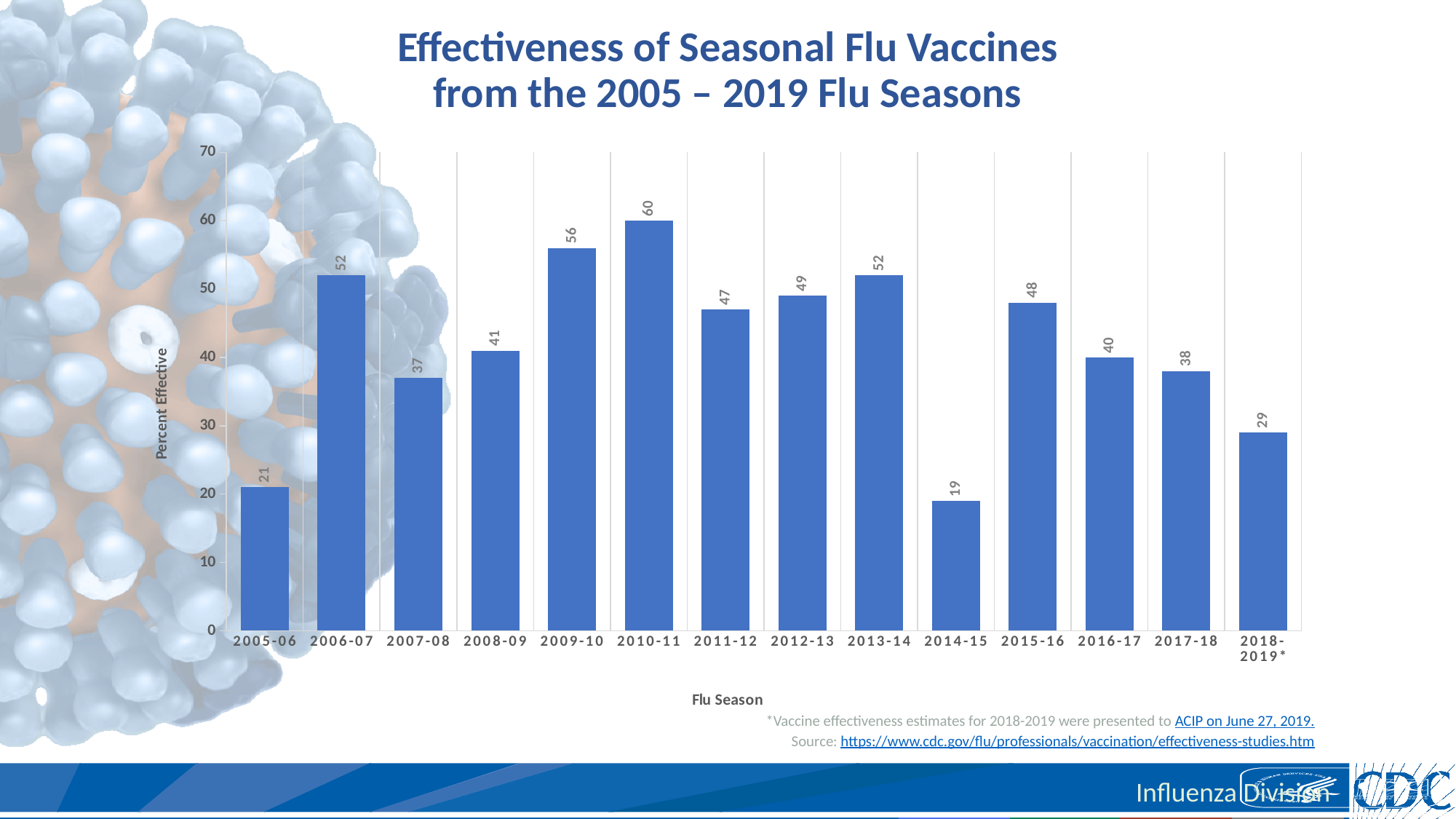
Is the value for the 2005-06 season greater or less than 30? less Which flu season has the highest vaccine effectiveness? 2010-11 Which flu season has the lowest vaccine effectiveness? 2014-15 What kind of chart is shown on the slide? bar chart Which season had higher vaccine effectiveness, 2009-10 or 2013-14? 2009-10 What is the percent effective value for the 2014-15 flu season? 19 What is the percent effective value for the 2010-11 flu season? 60 What is the label of the vertical axis? Percent Effective How many flu seasons are shown on the chart? 14 What is the label of the horizontal axis? Flu Season What is the percent effective value for the 2018-2019* flu season? 29 What is the difference in percent effective between the 2010-11 and 2014-15 seasons? 41